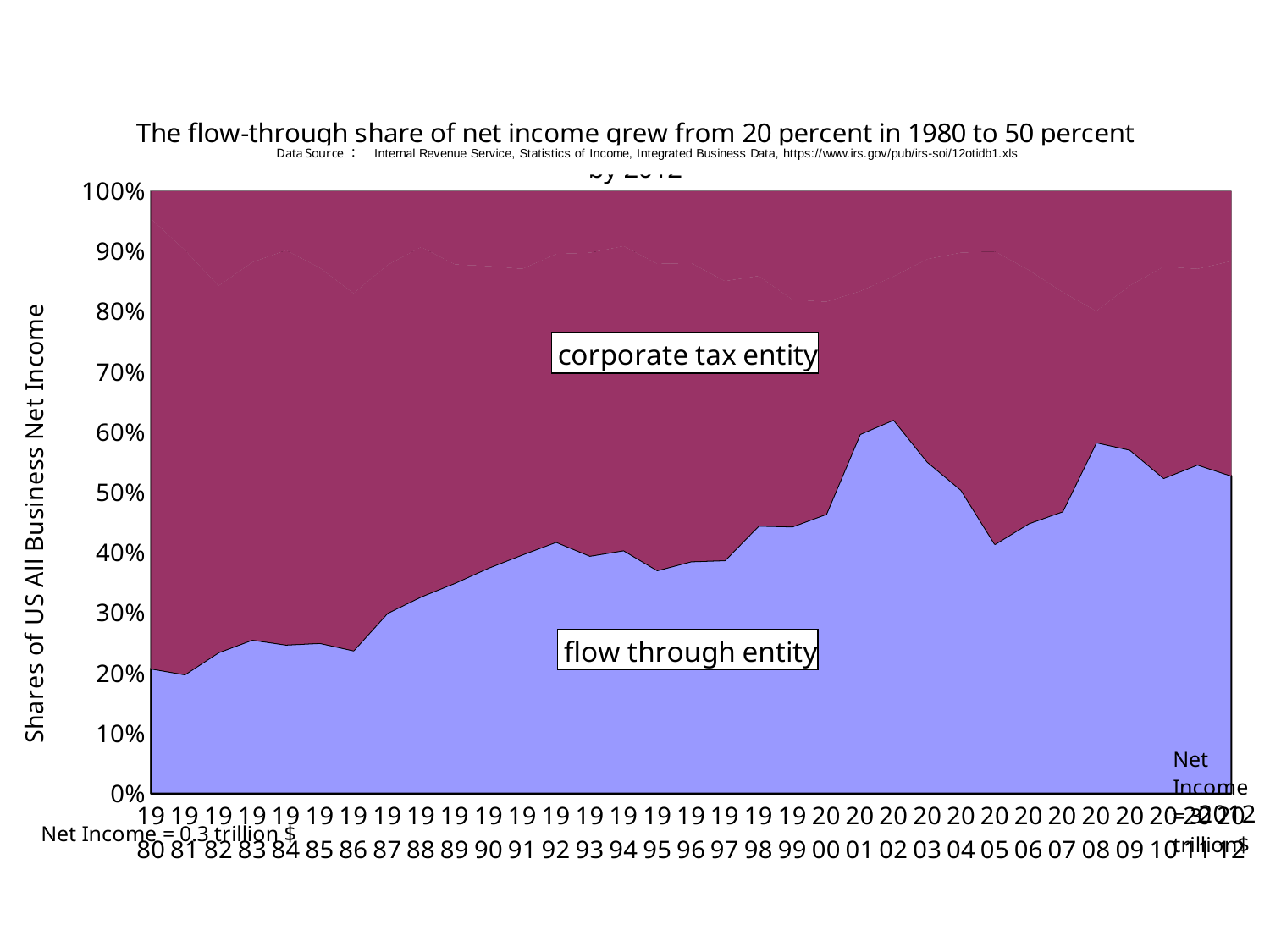
Is the flow through entity share in 1995 greater or less than 40%? less Does the flow through entity share generally rise or fall from 1980 to 2012? rise Is the flow through entity share in 2008 greater or less than 50%? greater What are the two entity types labelled in the chart? flow through entity and corporate tax entity How many years are shown along the x axis of the chart? 33 What kind of chart is shown on the slide? area chart Which year has the larger flow through entity share, 1990 or 2002? 2002 In which year is the flow through entity share highest? 2002 Is the flow through entity share in 1986 greater or less than 30%? less What is the y-axis label of the chart? Shares of US All Business Net Income How many series are plotted in the chart? 3